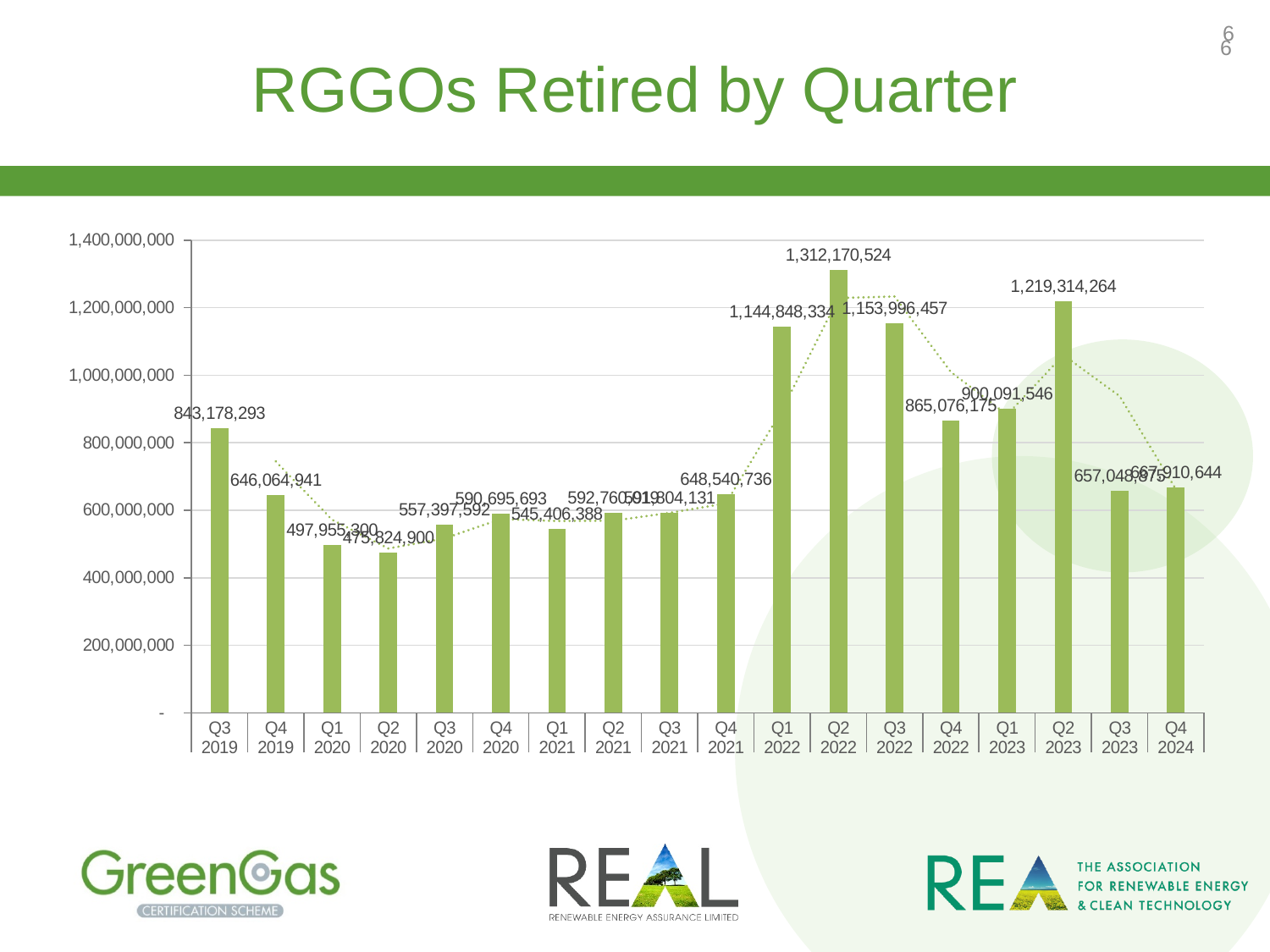
What is the value for Q3 2019? 843,178,293 Which is larger, the value for Q2 2023 or the value for Q3 2022? Q2 2023 Which quarter has the lowest number of RGGOs retired? Q2 2020 What is the value for Q2 2022? 1,312,170,524 Do the values rise or fall from Q3 2019 to Q2 2020? Fall How many quarters are shown on the x axis? 18 What is the difference between the values for Q3 2019 and Q4 2019? 197,113,352 Which quarter has the highest number of RGGOs retired? Q2 2022 What is the value for Q4 2022? 865,076,175 What is the difference between the values for Q2 2022 and Q1 2022? 167,322,190 Is the value for Q1 2023 greater or less than 800,000,000? greater What kind of chart is shown on the slide? Bar chart